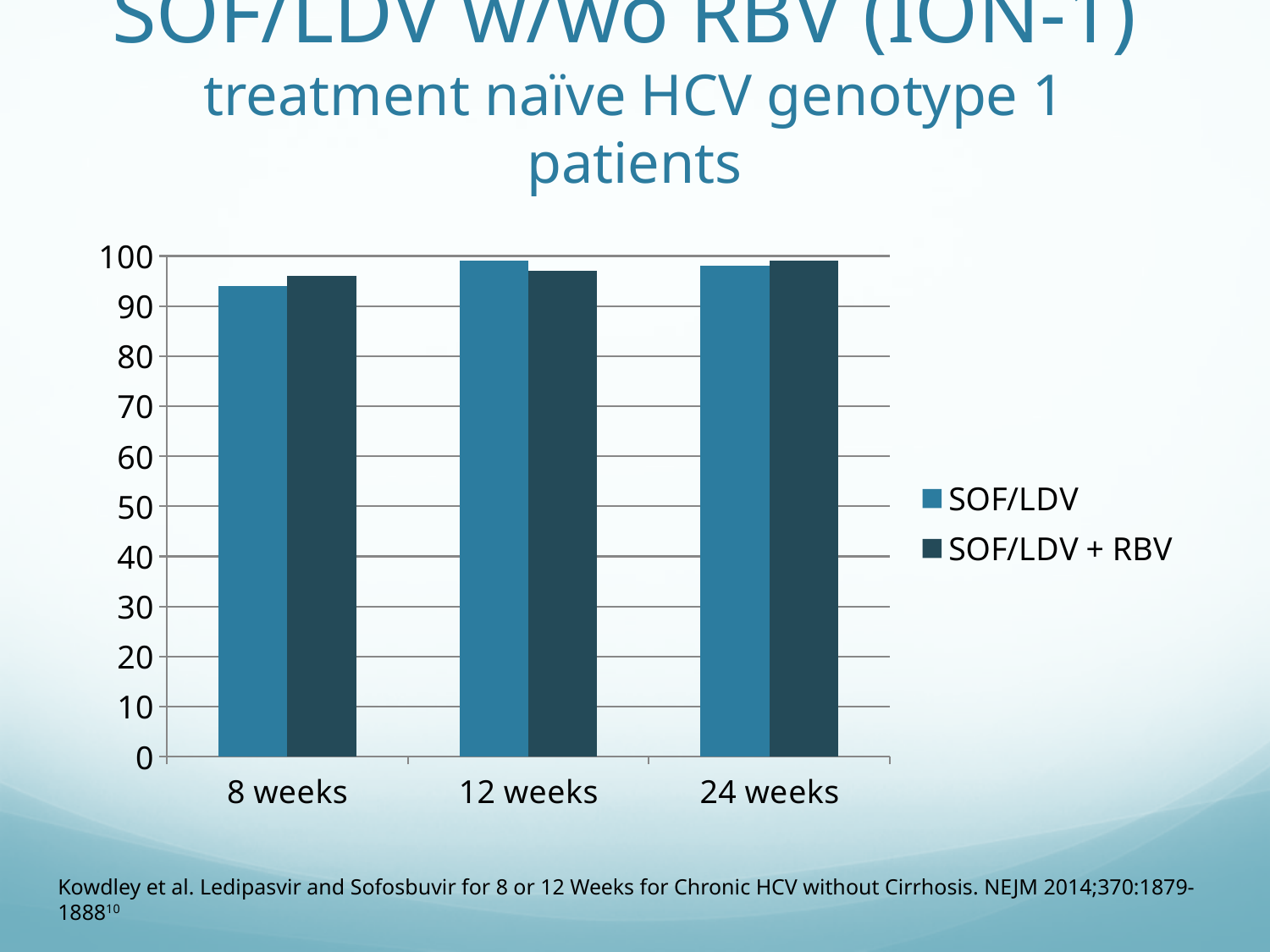
What is the highest value shown on the y axis? 100 Is the value for SOF/LDV + RBV at 24 weeks greater or less than 90? greater At 12 weeks, which is larger: SOF/LDV or SOF/LDV + RBV? SOF/LDV Which category on the x axis has the lowest SOF/LDV bar? 8 weeks Does the SOF/LDV value rise or fall from 8 weeks to 12 weeks? rise What kind of chart is shown on the slide? bar chart Is the value for SOF/LDV at 8 weeks greater or less than 90? greater Is the value for SOF/LDV at 8 weeks greater or less than 100? less How many categories are shown on the x axis? 3 At 8 weeks, which is larger: SOF/LDV or SOF/LDV + RBV? SOF/LDV + RBV What are the two series named in the legend? SOF/LDV and SOF/LDV + RBV How many series does the legend list? 2